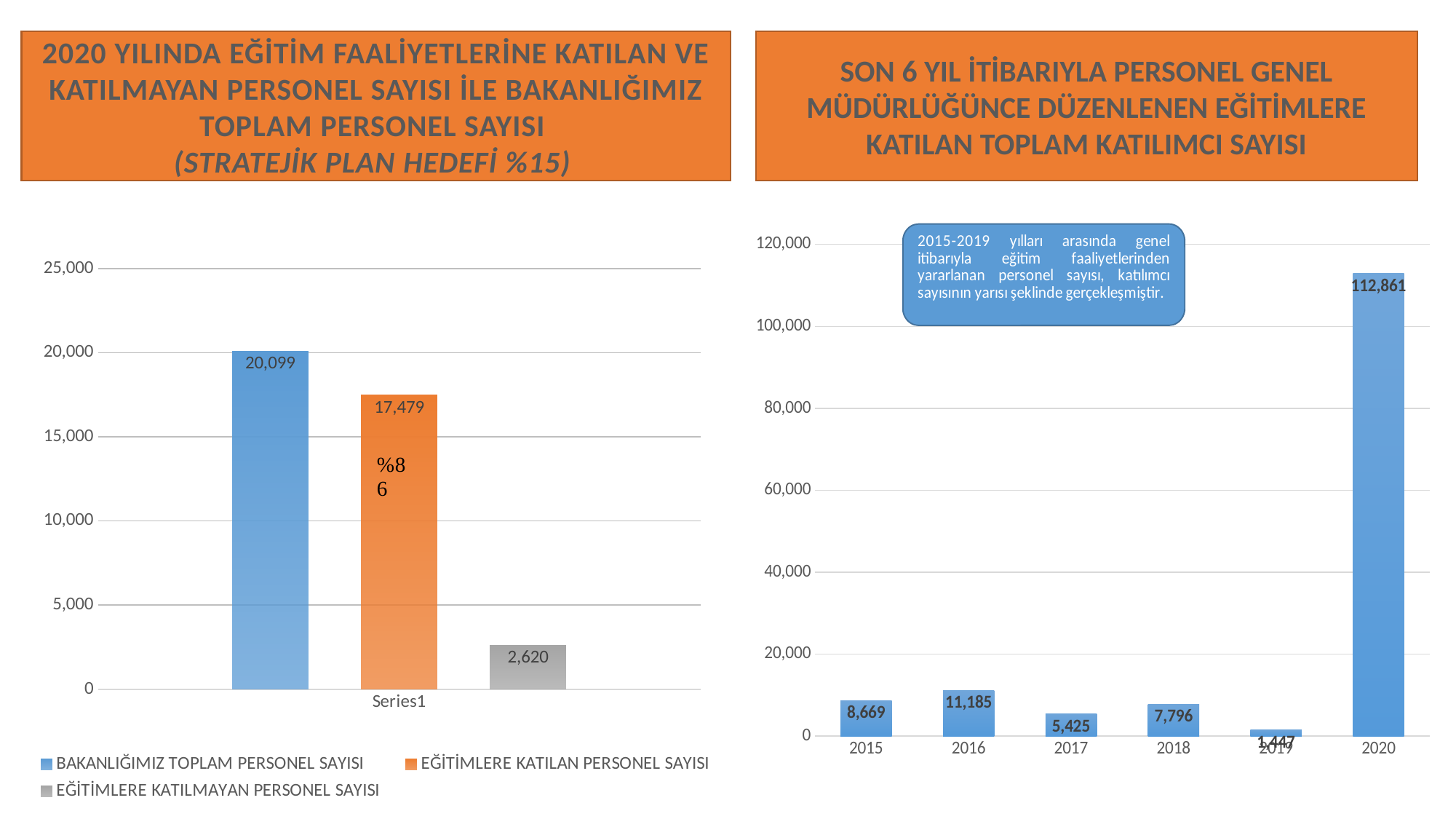
In the right chart, which year has the lowest value? 2019 In the left chart, what is the value for BAKANLIĞIMIZ TOPLAM PERSONEL SAYISI? 20,099 In the left chart, what is the value for EĞİTİMLERE KATILAN PERSONEL SAYISI? 17,479 In the left chart, what is the value for EĞİTİMLERE KATILMAYAN PERSONEL SAYISI? 2,620 In the right chart, what is the value for 2020? 112,861 In the right chart, what is the value for 2016? 11,185 In the left chart, what is the difference between BAKANLIĞIMIZ TOPLAM PERSONEL SAYISI and EĞİTİMLERE KATILAN PERSONEL SAYISI? 2,620 In the right chart, what is the difference between the values for 2016 and 2015? 2,516 In the left chart, which series has the lowest value? EĞİTİMLERE KATILMAYAN PERSONEL SAYISI In the right chart, what is the value for 2017? 5,425 In the right chart, which year has the highest value? 2020 In the left chart, how many series does the legend list? 3